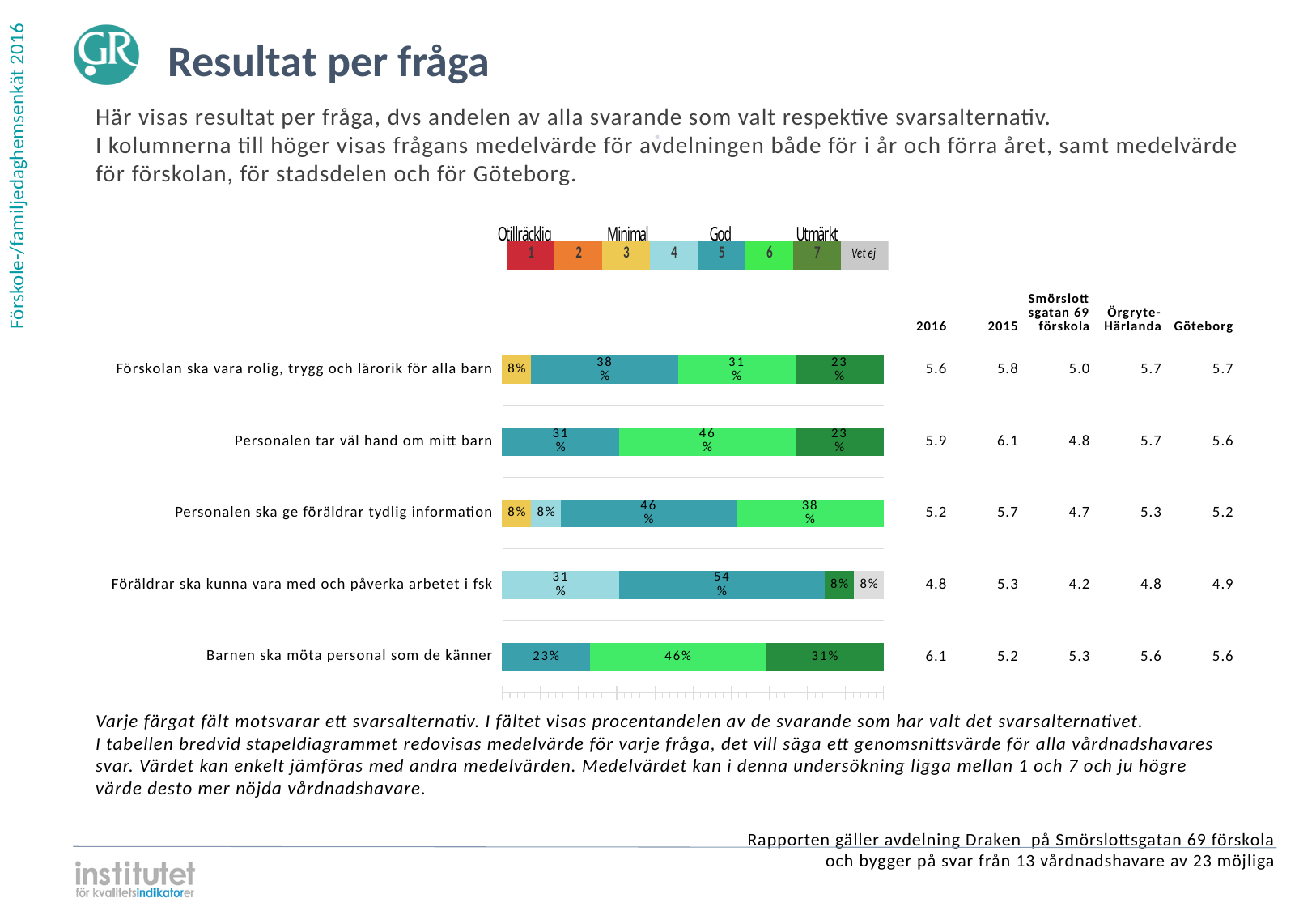
Which question has the largest share of respondents choosing alternative 7 (Utmärkt)? Barnen ska möta personal som de känner What is the difference between the alternative 5 share and the alternative 6 share for 'Förskolan ska vara rolig, trygg och lärorik för alla barn'? 7% What percentage of respondents chose alternative 7 (Utmärkt) for 'Barnen ska möta personal som de känner'? 31% What label does the legend give to alternative 7? Utmärkt What type of chart is shown on the slide? Stacked bar chart What percentage of respondents answered 'Vet ej' for 'Föräldrar ska kunna vara med och påverka arbetet i fsk'? 8% What is the combined share of alternatives 6 and 7 for 'Personalen tar väl hand om mitt barn'? 69% What percentage of respondents chose alternative 5 for 'Föräldrar ska kunna vara med och påverka arbetet i fsk'? 54% For 'Personalen ska ge föräldrar tydlig information', which is larger: the share for alternative 5 or the share for alternative 6? Alternative 5 How many answer alternatives does the legend above the chart list? 8 How many questions (categories) are plotted in the bar chart? 5 What percentage of respondents chose alternative 6 for 'Personalen tar väl hand om mitt barn'? 46%